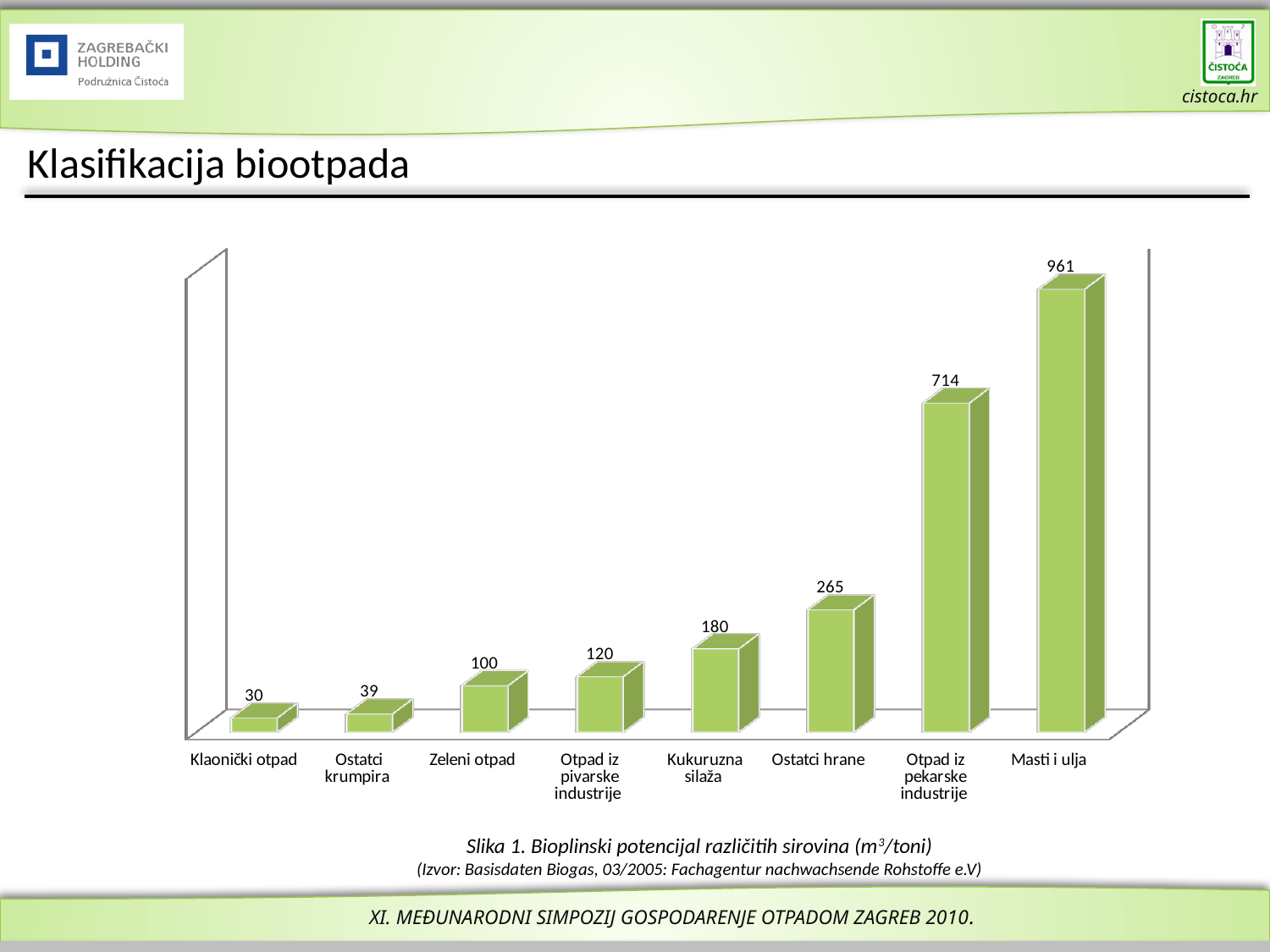
Which is larger, the value for Zeleni otpad or the value for Otpad iz pivarske industrije? Otpad iz pivarske industrije What is the value for Otpad iz pekarske industrije? 714 Which category has the highest value? Masti i ulja What is the value for Kukuruzna silaža? 180 Do the values rise or fall from left to right along the x axis? Rise What kind of chart is shown on the slide? Bar chart What is the value for Klaonički otpad? 30 What is the difference between the values for Masti i ulja and Otpad iz pekarske industrije? 247 What is the value for Masti i ulja? 961 What is the difference between the values for Ostatci hrane and Kukuruzna silaža? 85 How many categories are shown in the chart? 8 Which category has the lowest value? Klaonički otpad